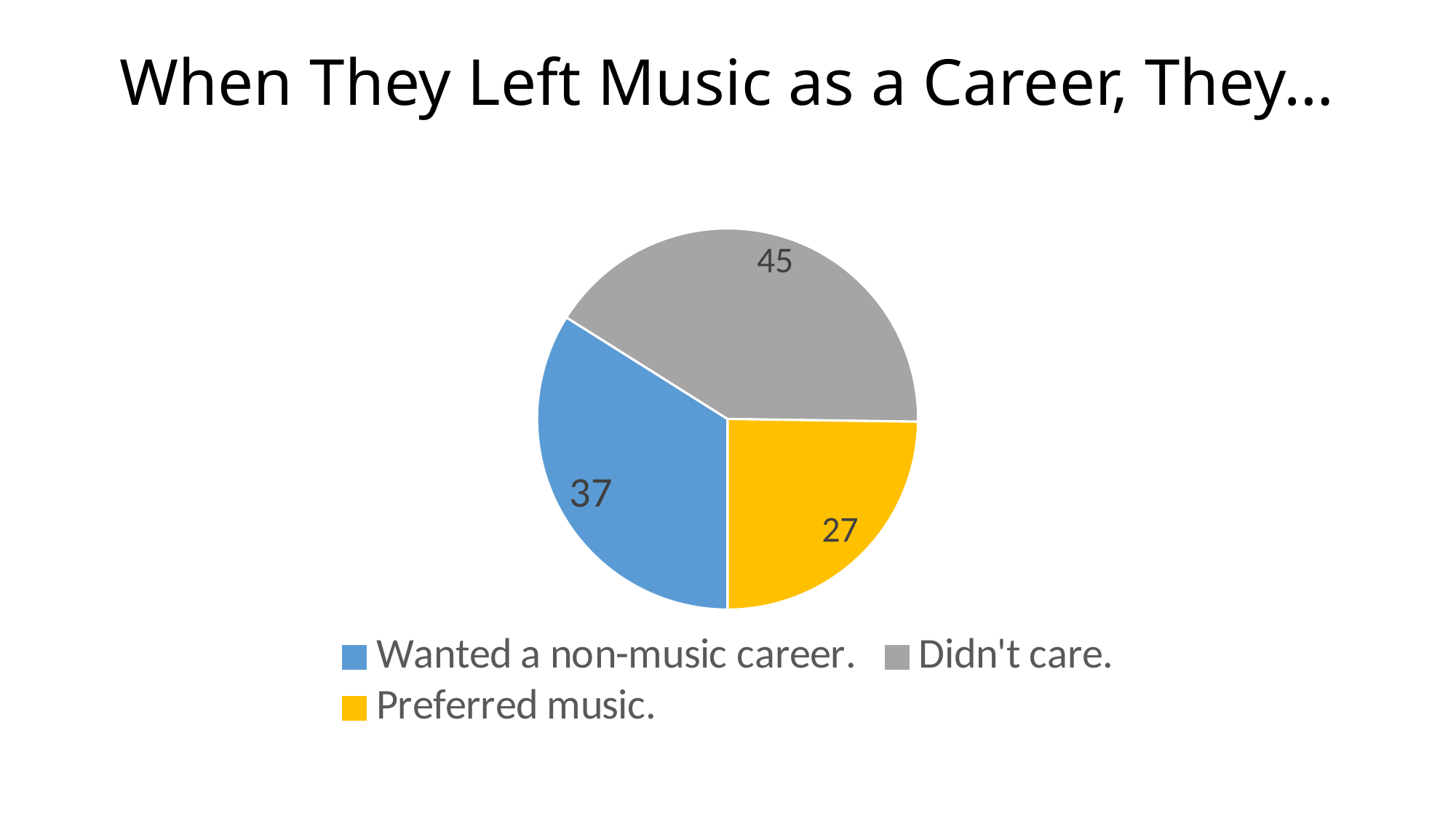
What value is shown for the "Didn't care." slice? 45 What is the difference between the "Didn't care." value and the "Wanted a non-music career." value? 8 What value is shown for the "Preferred music." slice? 27 What is the title of the chart? When They Left Music as a Career, They... Which category has the smallest slice of the pie? Preferred music. What kind of chart is shown on the slide? Pie chart What is the difference between the "Didn't care." value and the "Preferred music." value? 18 What value is shown for the "Wanted a non-music career." slice? 37 Which is larger: the value for "Wanted a non-music career." or the value for "Preferred music."? Wanted a non-music career. What colour is the "Preferred music." slice? Yellow How many slices does the pie chart have? 3 Which category has the largest slice of the pie? Didn't care.